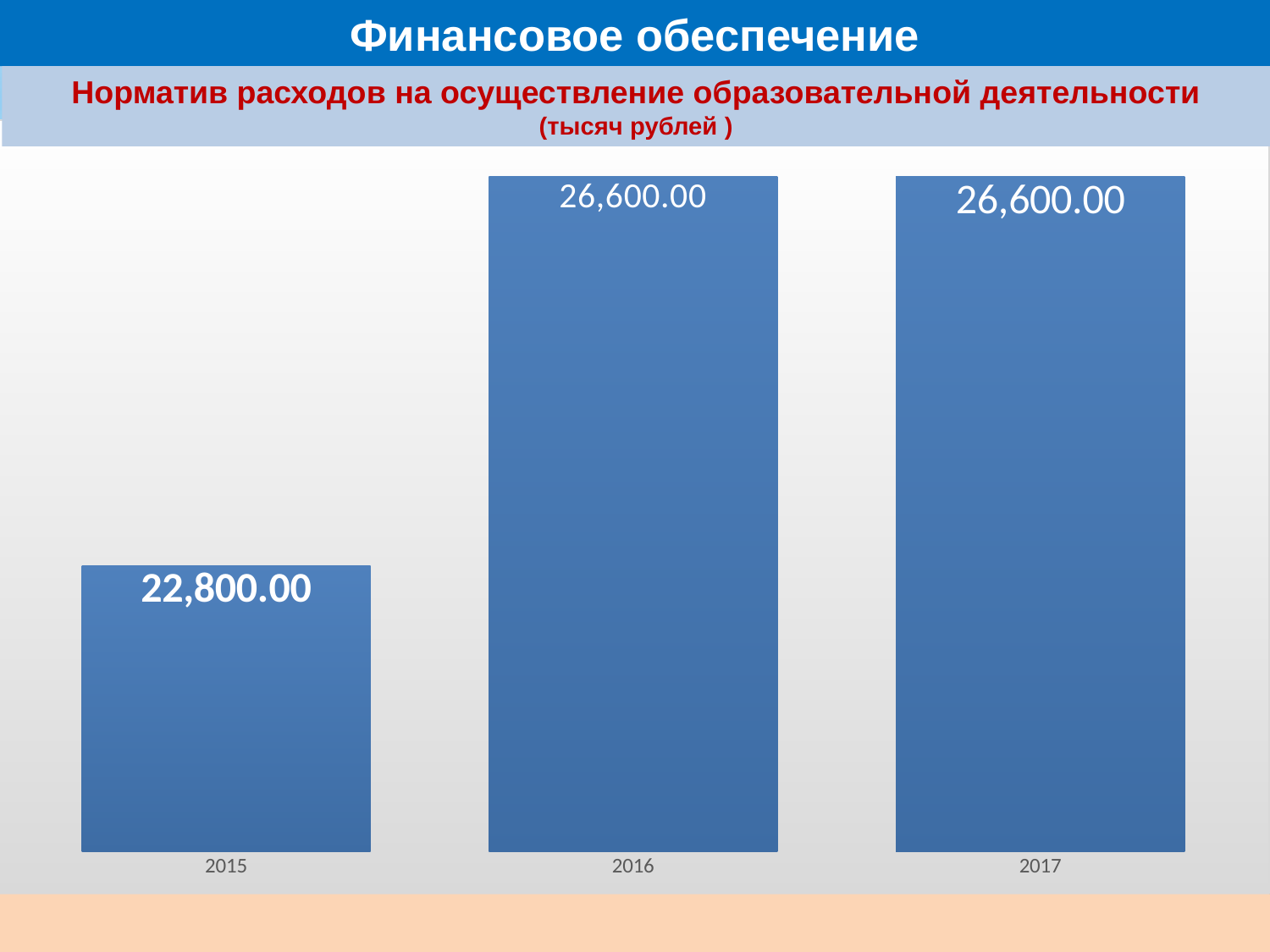
Does the value rise or fall from 2015 to 2016? Rise What kind of chart is shown on the slide? Bar chart What unit is given in the chart title? тысяч рублей How many years are shown on the chart? 3 What is the value for 2015? 22,800.00 What is the title of the chart? Норматив расходов на осуществление образовательной деятельности (тысяч рублей) Which year has the lowest value? 2015 What is the value for 2016? 26,600.00 What is the value for 2017? 26,600.00 Which is larger, the value for 2015 or the value for 2016? 2016 Are the values for 2016 and 2017 equal? Yes What is the difference between the values for 2016 and 2015? 3,800.00